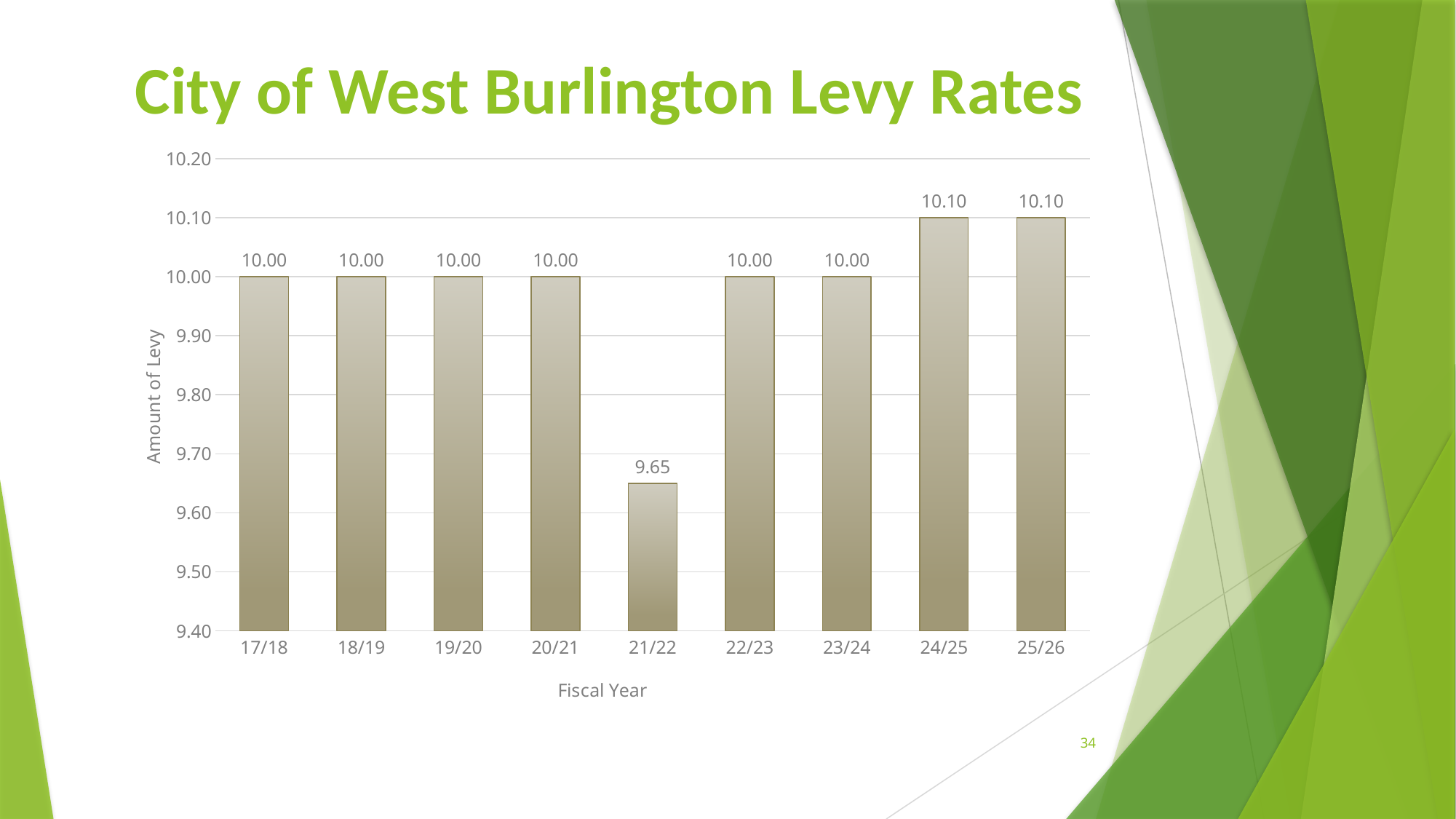
What is the levy rate for fiscal year 21/22? 9.65 What is the difference between the levy rate in 24/25 and the levy rate in 23/24? 0.10 Is the value for 21/22 greater or less than 9.70? less What is the levy rate for fiscal year 24/25? 10.10 Which is larger, the levy rate for 20/21 or the levy rate for 21/22? 20/21 What is the title of the chart? City of West Burlington Levy Rates Which fiscal year has the lowest levy rate? 21/22 What kind of chart is shown on the slide? Bar chart What is the levy rate for fiscal year 17/18? 10.00 How many fiscal years are shown on the x axis? 9 What is the label of the y axis? Amount of Levy What is the difference between the levy rate in 25/26 and the levy rate in 21/22? 0.45